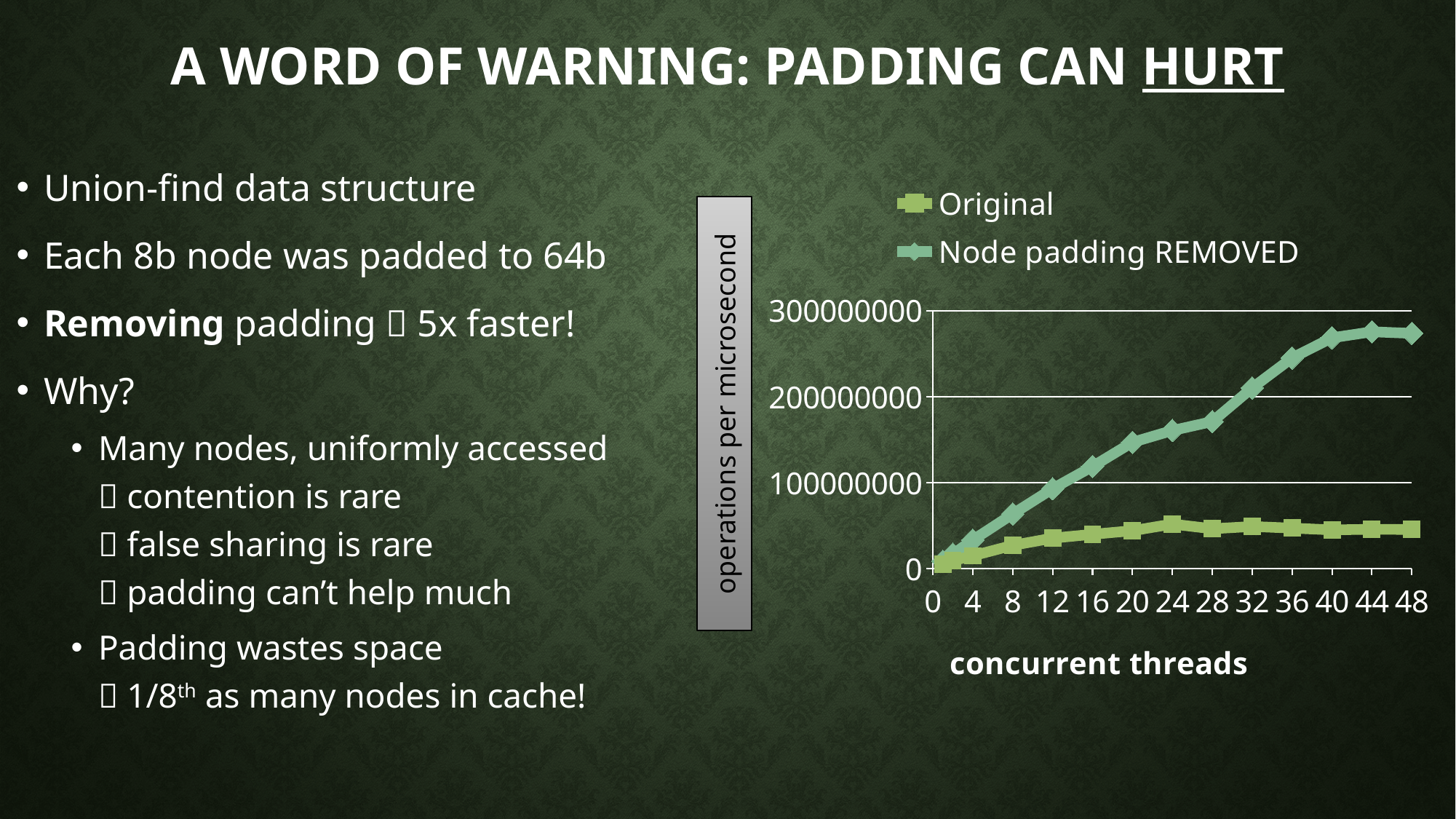
Is the value for Node padding REMOVED at 48 concurrent threads greater or less than 200000000? greater Is the value for Original at 48 concurrent threads greater or less than 100000000? less Which series has the higher value at 32 concurrent threads? Node padding REMOVED What is the label of the chart's x axis? concurrent threads How many series does the chart legend list? 2 Does the Node padding REMOVED series generally rise or fall as the number of concurrent threads increases? rise Which series has the higher value at 48 concurrent threads? Node padding REMOVED What kind of chart is shown on the slide? line chart Is the value for Node padding REMOVED at 8 concurrent threads greater or less than 100000000? less What are the two series named in the chart legend? Original and Node padding REMOVED